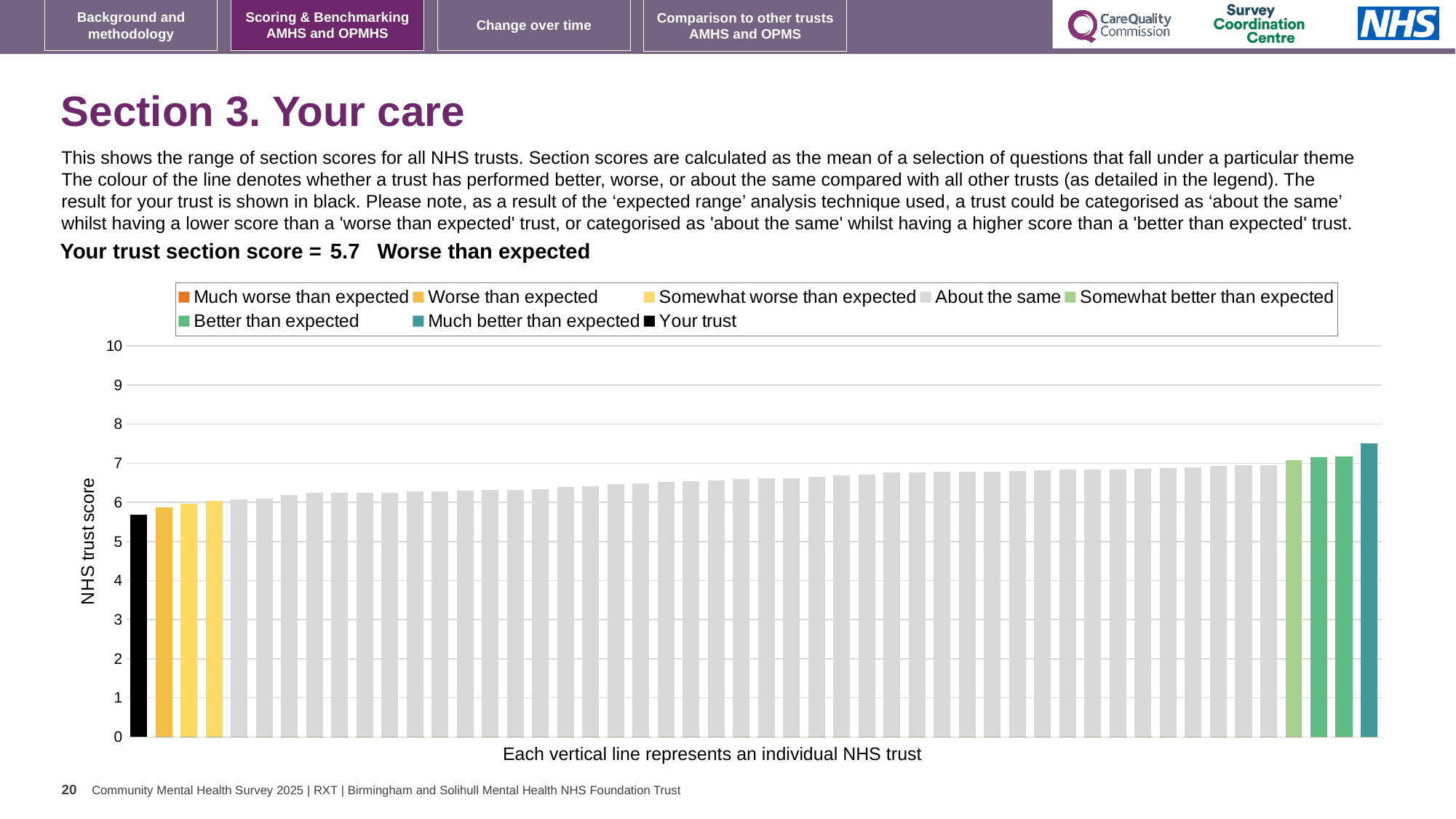
Do the bar values rise or fall from left to right along the x axis? rise Which category is your trust's section score placed in? Worse than expected How many entries does the chart legend list? 8 What is the label on the vertical axis of the chart? NHS trust score How many bars are coloured as 'Worse than expected' (excluding your trust)? 1 What is the section score for your trust? 5.7 Is the value of the tallest bar on the chart greater or less than 7? greater Which bar is the lowest on the chart? Your trust (the black bar) What kind of chart is shown on the slide? bar chart Which is larger, the leftmost bar or the rightmost bar? the rightmost bar Is the value of the tallest bar on the chart greater or less than 8? less Is the value of the black 'Your trust' bar greater or less than 6? less